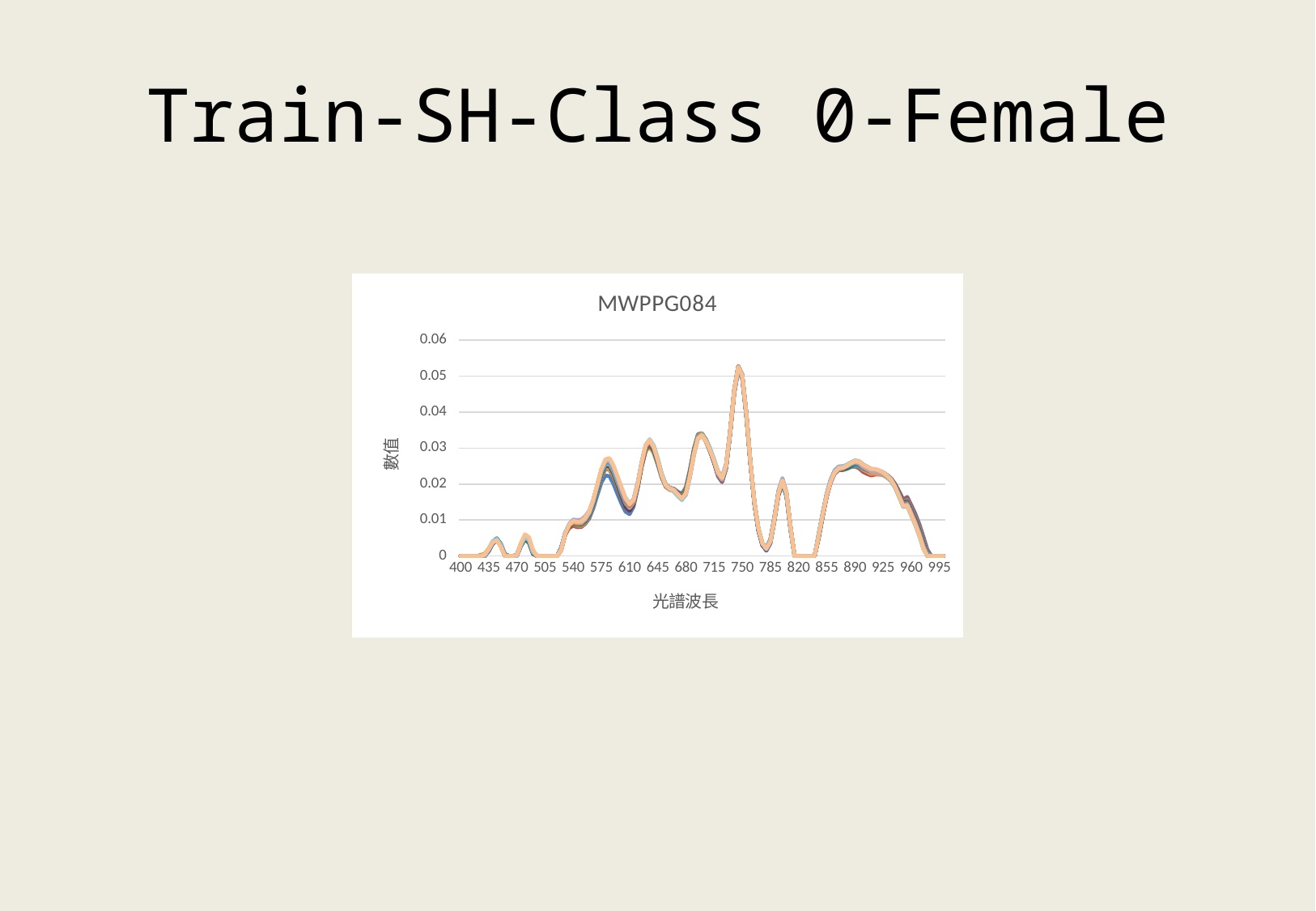
Is the value at 750 larger or smaller than the value at 575? larger How many tick labels are shown on the x axis? 18 Is the value at 890 greater or less than 0.02? greater Do the values rise or fall along the x axis from 925 to 995? fall Is the value at 995 greater or less than 0.01? less What kind of chart is shown on the slide? line chart Is the value at 820 greater or less than 0.01? less Around which x-axis tick does the line reach its highest value? 750 What is the label on the x axis of the chart? 光譜波長 What is the title of the chart? MWPPG084